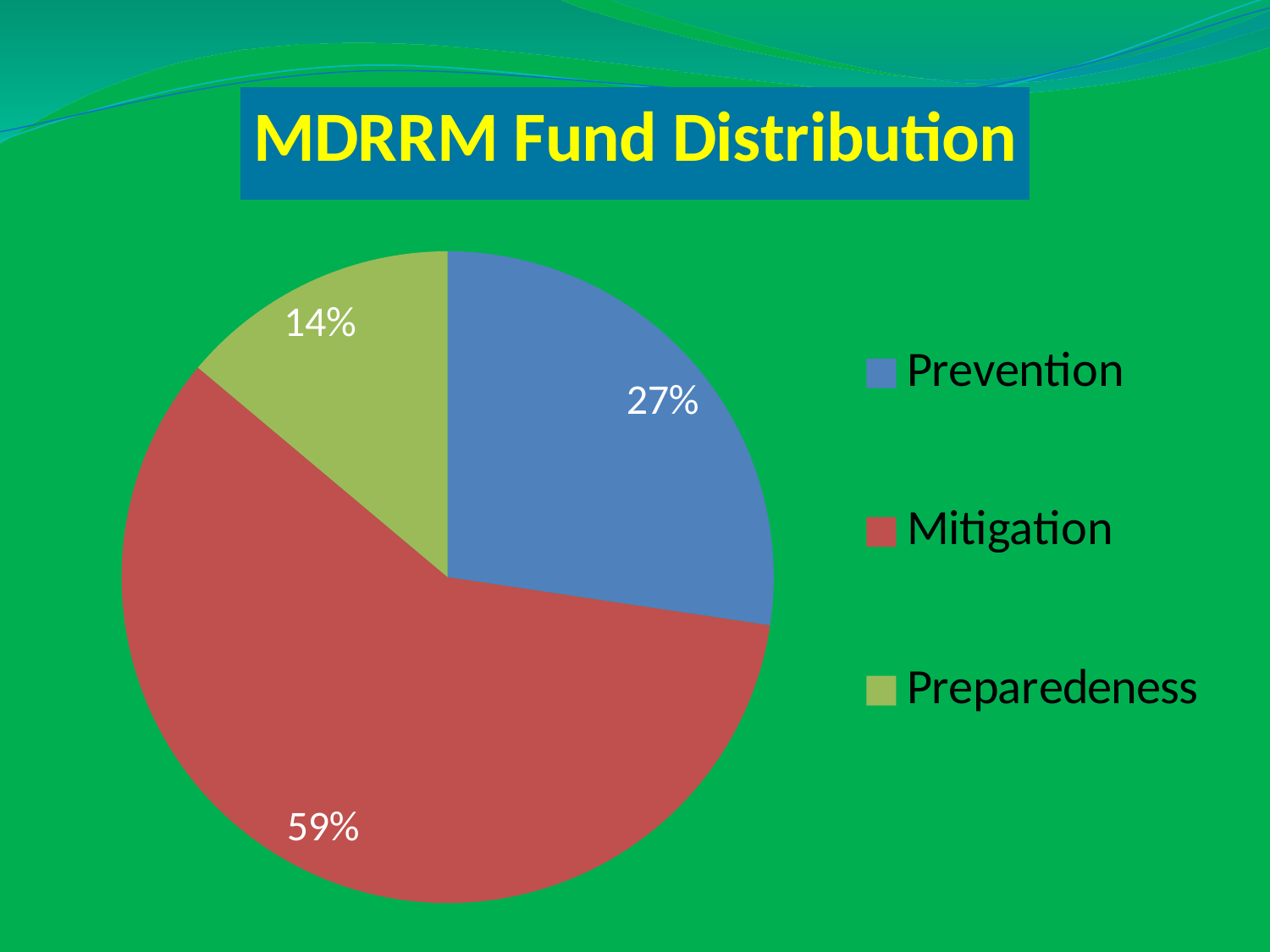
What is the title of the chart? MDRRM Fund Distribution How many categories does the pie chart show? 3 What kind of chart is shown on the slide? Pie chart What share of the MDRRM fund goes to Mitigation? 59% Which category receives the smallest share of the MDRRM fund? Preparedeness What share of the MDRRM fund goes to Preparedeness? 14% What share of the MDRRM fund goes to Prevention? 27% Which category receives the largest share of the MDRRM fund? Mitigation Which colour represents Mitigation in the pie chart? Red What is the difference in percentage points between the Prevention and Preparedeness shares? 13 Which is larger, the share for Prevention or the share for Preparedeness? Prevention What is the difference in percentage points between the Mitigation and Prevention shares? 32